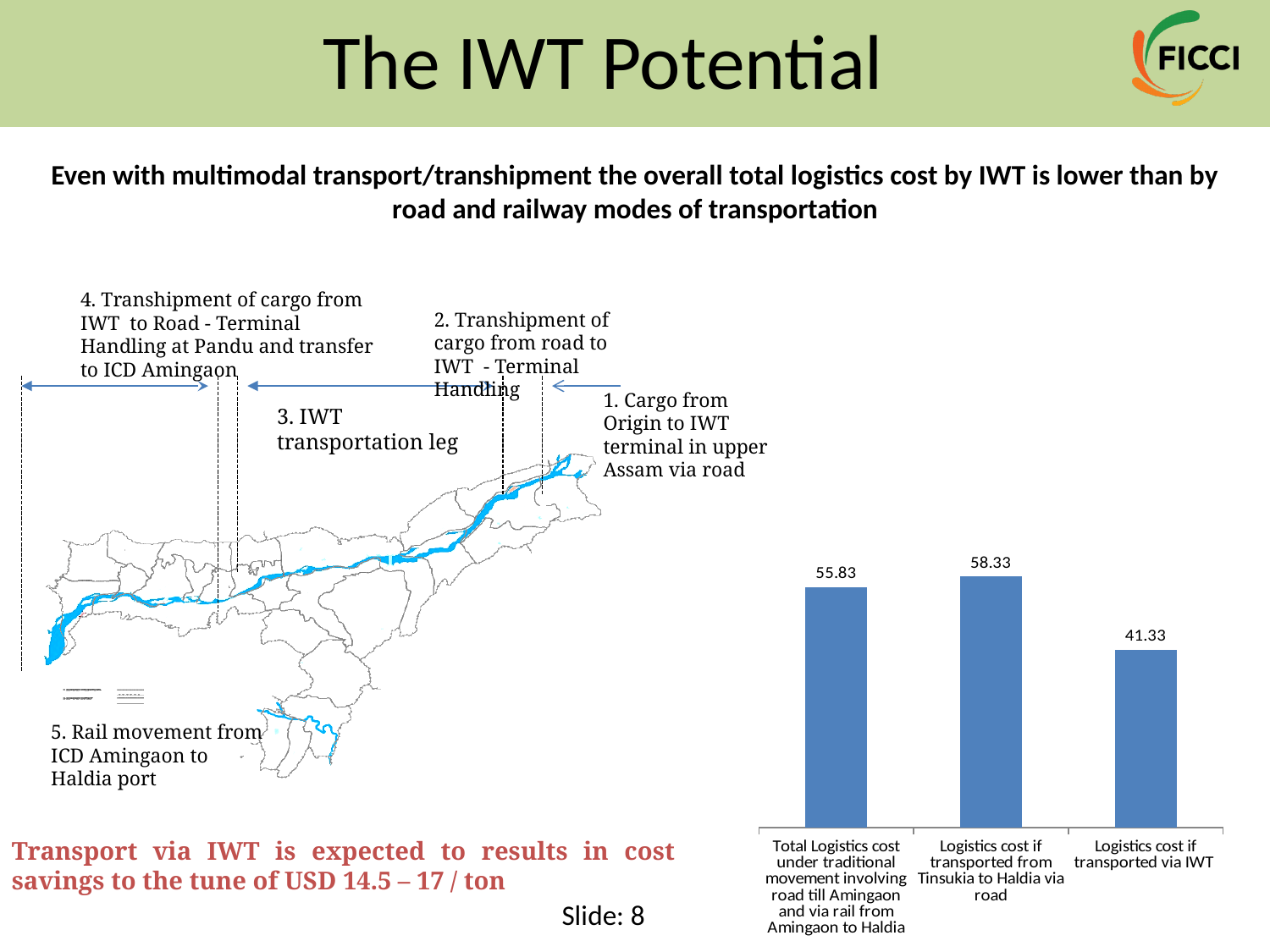
Which is larger: the logistics cost if transported via road from Tinsukia to Haldia, or the total logistics cost under traditional movement? Logistics cost if transported from Tinsukia to Haldia via road What is the value of the bar for total logistics cost under traditional movement involving road till Amingaon and via rail from Amingaon to Haldia? 55.83 What is the difference between the logistics cost via road (Tinsukia to Haldia) and the logistics cost via IWT? 17.00 What is the difference between the total logistics cost under traditional movement and the logistics cost via IWT? 14.50 How many bars are shown in the chart? 3 What is the difference between the logistics cost via road (Tinsukia to Haldia) and the total logistics cost under traditional movement? 2.50 What is the value of the bar for logistics cost if transported from Tinsukia to Haldia via road? 58.33 Which category has the highest bar in the chart? Logistics cost if transported from Tinsukia to Haldia via road Which category has the lowest bar in the chart? Logistics cost if transported via IWT What kind of chart is shown on the slide? Bar chart What is the value of the bar for logistics cost if transported via IWT? 41.33 What colour are the bars in the chart? Blue